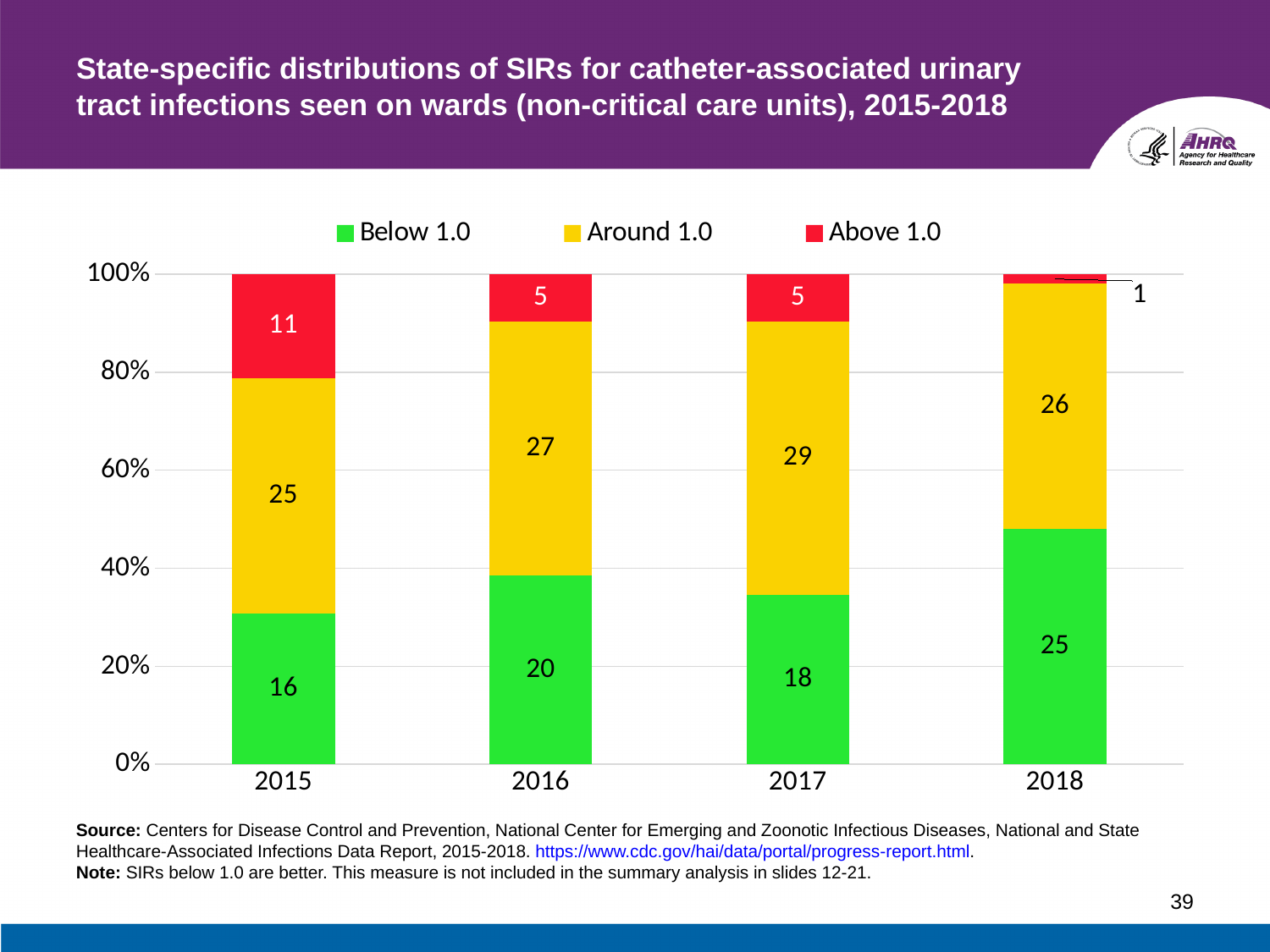
What kind of chart is shown on the slide? Stacked bar chart Which is larger, the Around 1.0 value in 2016 or in 2017? 2017 In which year is the Below 1.0 value lowest? 2015 What is the difference between the Below 1.0 values for 2018 and 2015? 9 What is the total of the stacked bar for 2016? 52 How many years are shown on the x axis? 4 What is the value for Above 1.0 in 2018? 1 What is the value for Around 1.0 in 2017? 29 In which year is the Above 1.0 value highest? 2015 What is the value for Below 1.0 in 2015? 16 How many series does the legend list? 3 Does the Above 1.0 value rise or fall from 2015 to 2018? Fall